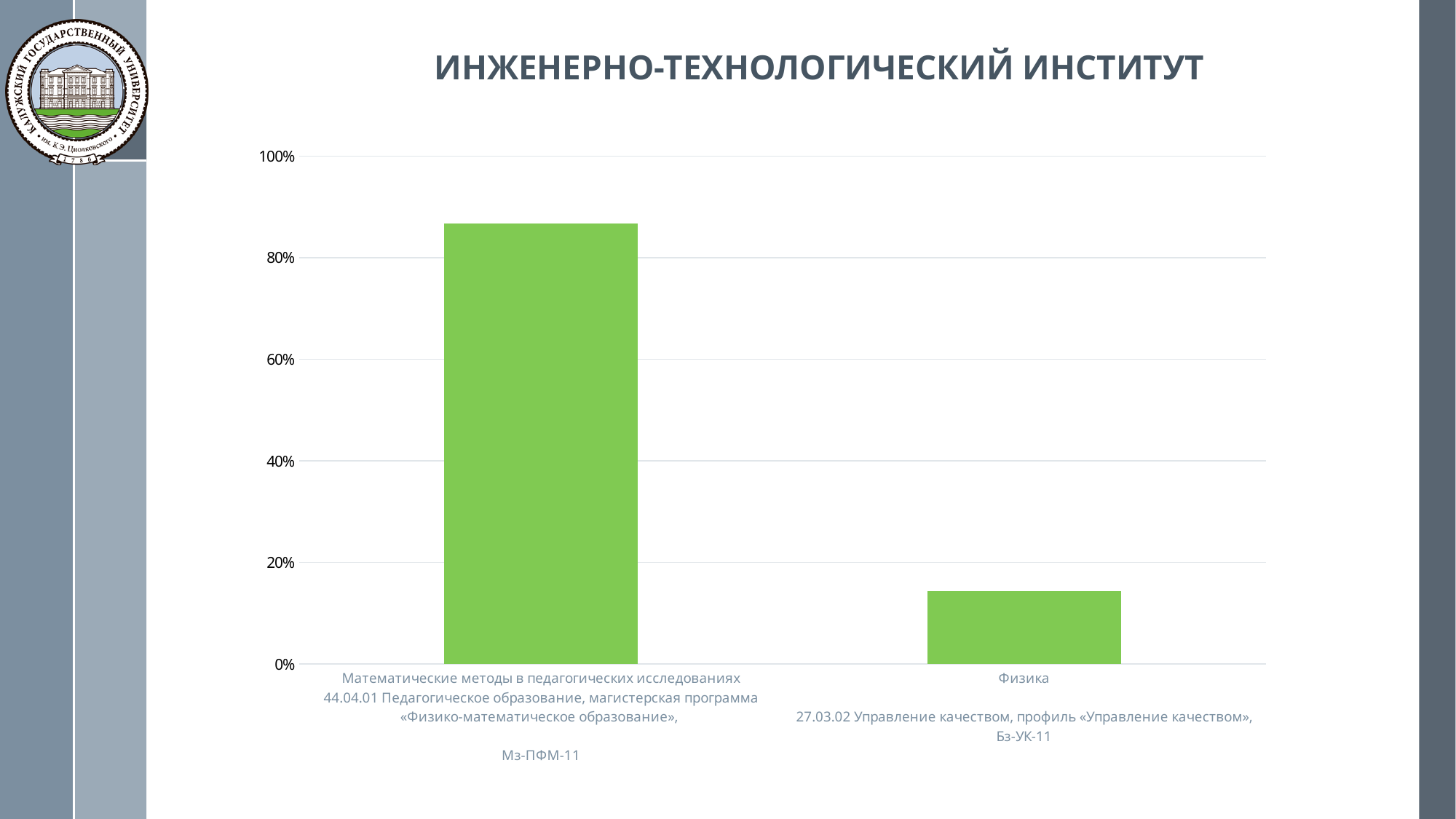
Is the value for Математические методы в педагогических исследованиях greater or less than 100%? less Which is larger: the value for Математические методы в педагогических исследованиях or the value for Физика? Математические методы в педагогических исследованиях Which category has the lowest value? Физика Is the value for Математические методы в педагогических исследованиях greater or less than 80%? greater What colour are the bars in the chart? green Is the value for Физика greater or less than 20%? less Which category has the highest value? Математические методы в педагогических исследованиях What kind of chart is shown on the slide? bar chart How many bars (categories) does the chart show? 2 Do the values rise or fall from left to right along the x axis? fall What is the title shown at the top of the slide? ИНЖЕНЕРНО-ТЕХНОЛОГИЧЕСКИЙ ИНСТИТУТ